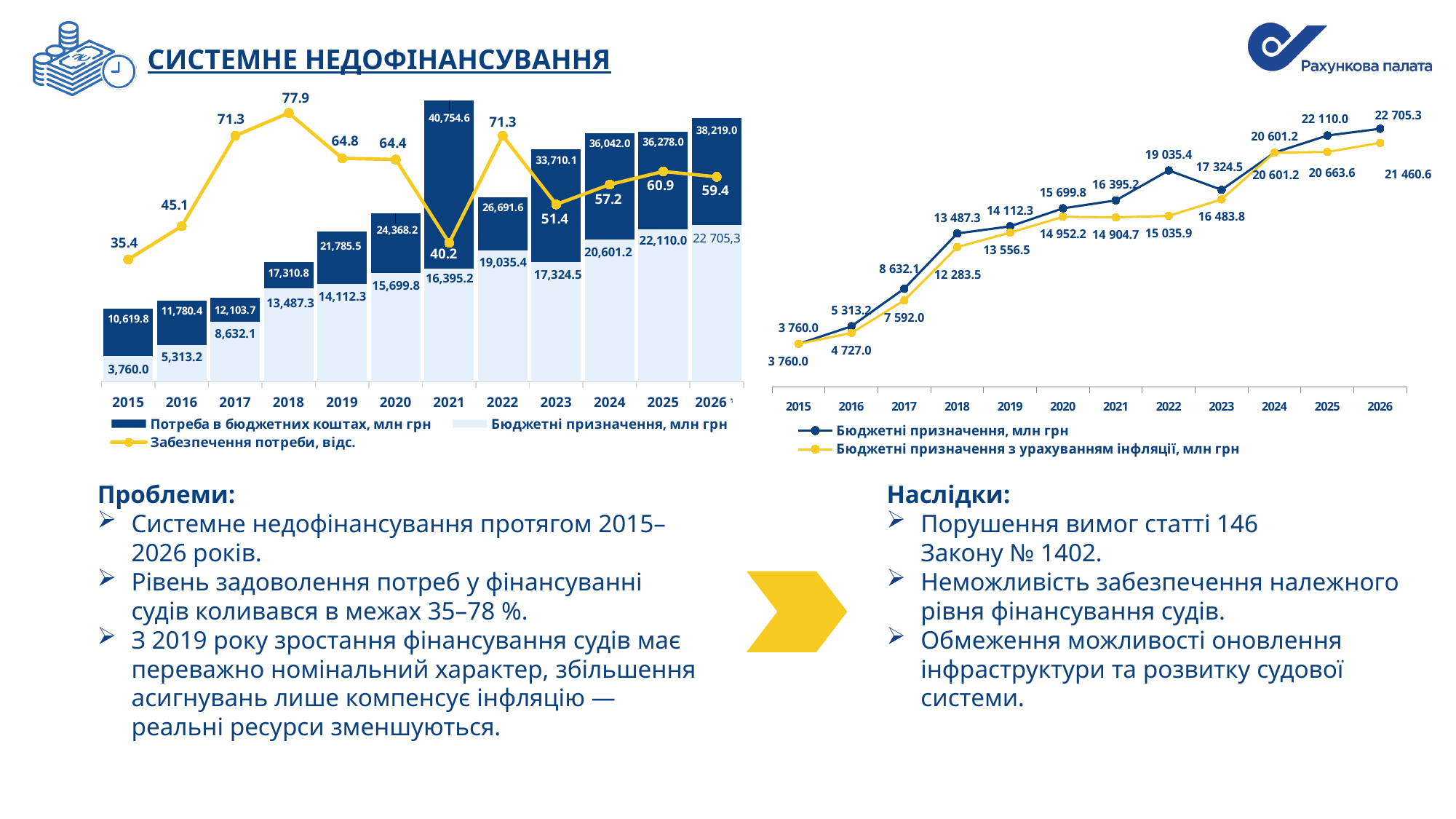
On the right chart, which is larger in 2022: 'Бюджетні призначення, млн грн' or 'Бюджетні призначення з урахуванням інфляції, млн грн'? Бюджетні призначення, млн грн On the left chart, what is the value of 'Забезпечення потреби, відс.' for 2018? 77.9 On the left chart, in which year is 'Забезпечення потреби, відс.' the highest? 2018 How many series does the legend of the left chart list? 3 On the left chart, what is the value of 'Бюджетні призначення, млн грн' for 2015? 3,760.0 How many years are shown on the x axis of the right chart? 12 On the left chart, what is the difference between 'Потреба в бюджетних коштах' and 'Бюджетні призначення' in 2025? 14,168.0 What kind of chart is the right chart? Line chart On the left chart, in which year is 'Забезпечення потреби, відс.' the lowest? 2015 On the right chart, what is the value of 'Бюджетні призначення з урахуванням інфляції, млн грн' for 2026? 21 460.6 On the right chart, does 'Бюджетні призначення, млн грн' generally rise or fall from 2015 to 2026? Rise On the left chart, what is the value of 'Потреба в бюджетних коштах, млн грн' for 2021? 40,754.6